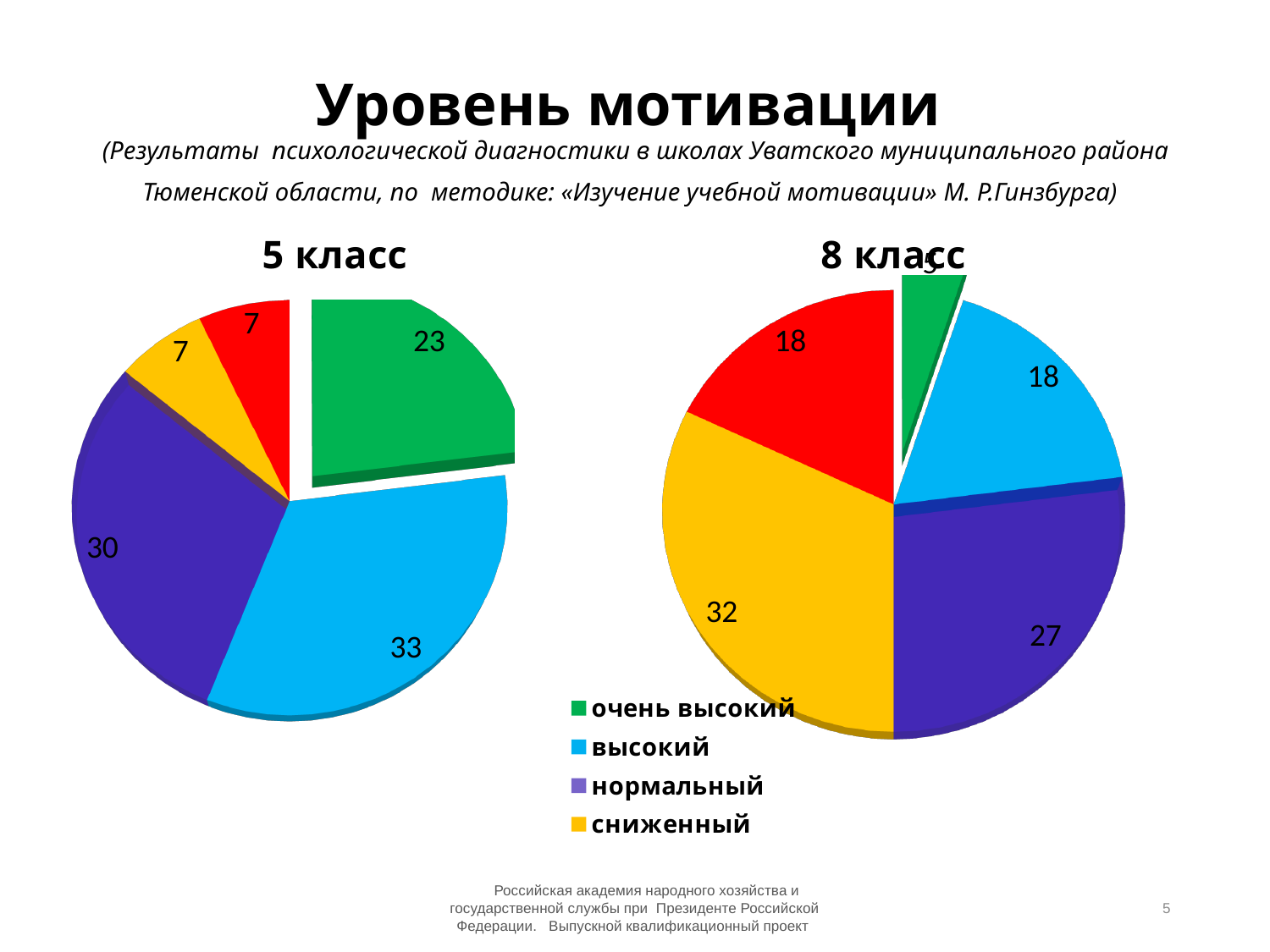
How many categories does the legend list? 4 In the 5 класс chart, what is the value for очень высокий? 23 In the 8 класс chart, what is the value for нормальный? 27 What kind of chart is used for the 5 класс data? pie chart In the 5 класс chart, what is the value for сниженный? 7 In the 5 класс chart, what is the value for нормальный? 30 In the 5 класс chart, what is the value for высокий? 33 In the 8 класс chart, what is the value for высокий? 18 In the 5 класс chart, which legend category has the largest slice? высокий In the 8 класс chart, what is the difference between the values for сниженный and нормальный? 5 In the 8 класс chart, what is the value for сниженный? 32 In the 8 класс chart, which legend category has the largest slice? сниженный